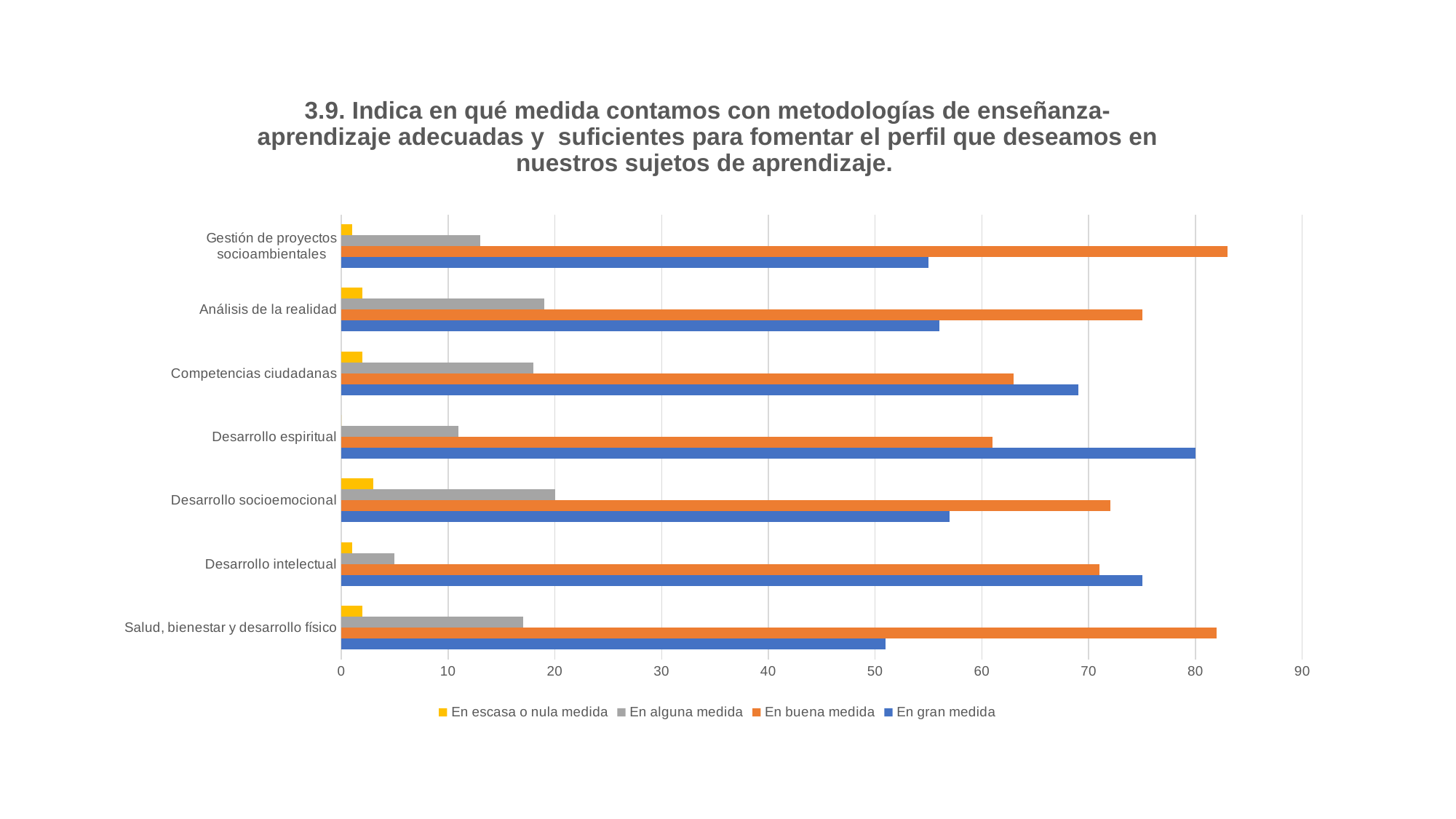
Which category has the lowest value for 'En gran medida'? Salud, bienestar y desarrollo físico Is the value for 'En buena medida' in 'Gestión de proyectos socioambientales' greater or less than 80? greater Which category has the highest value for 'En gran medida'? Desarrollo espiritual How many series does the legend list? 4 What colour represents the 'En gran medida' series in the chart? blue How many categories are plotted on the vertical axis of the chart? 7 Which category has the lowest value for 'En alguna medida'? Desarrollo intelectual For 'Análisis de la realidad', which is larger: 'En buena medida' or 'En gran medida'? En buena medida For 'Competencias ciudadanas', which is larger: 'En gran medida' or 'En buena medida'? En gran medida Is the value for 'En gran medida' in 'Salud, bienestar y desarrollo físico' greater or less than 60? less What kind of chart is shown on the slide? bar chart Is the value for 'En alguna medida' in 'Desarrollo intelectual' greater or less than 10? less